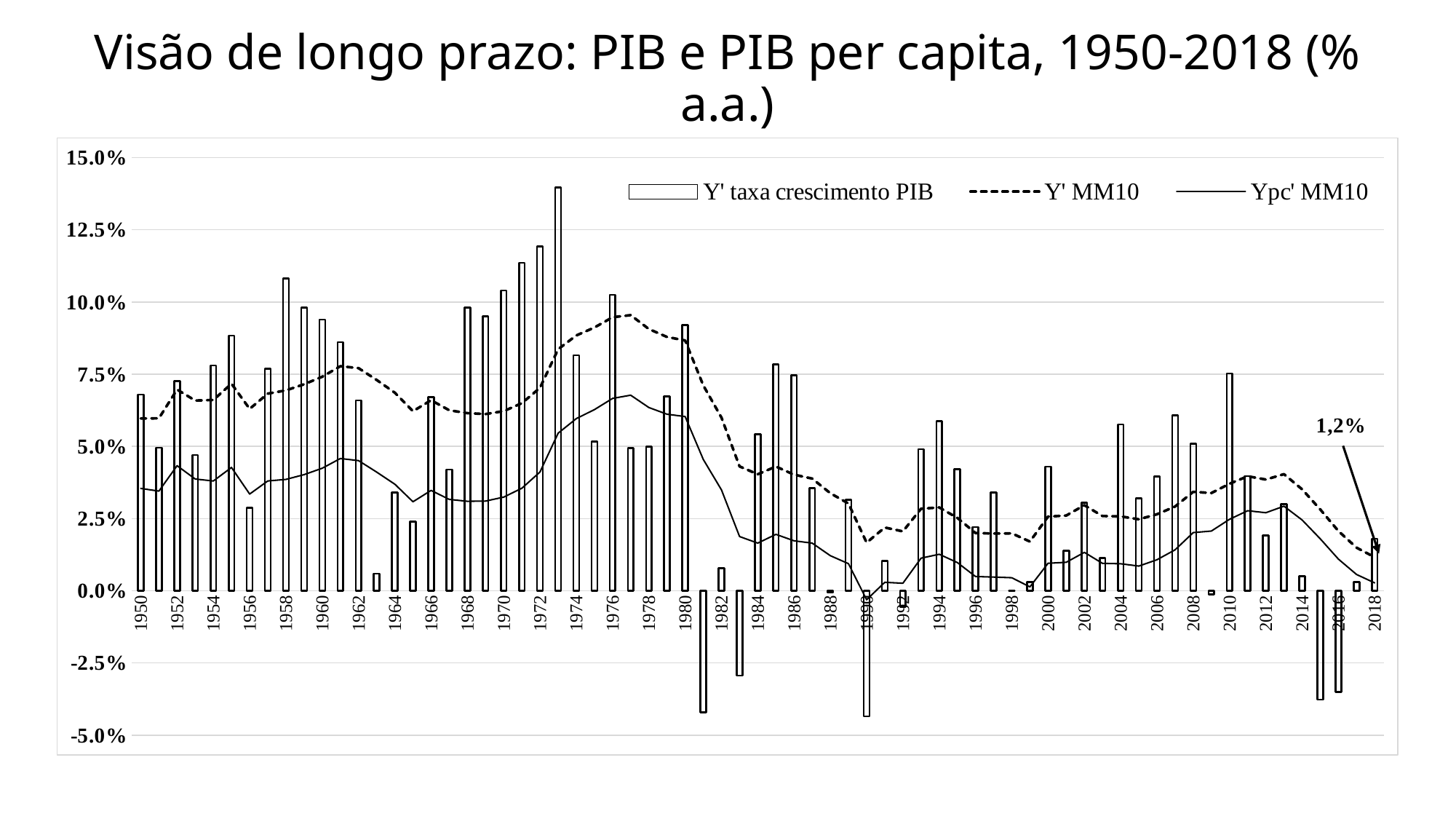
Which series in the legend is drawn as a dashed line? Y' MM10 Is the Y' taxa crescimento PIB value for 1981 greater or less than -2.5%? less How many series does the legend list? 3 Which year has the highest Y' taxa crescimento PIB bar? 1973 What is the title of the chart? Visão de longo prazo: PIB e PIB per capita, 1950-2018 (% a.a.) Is the Y' taxa crescimento PIB value for 1973 greater or less than 12.5%? greater What kind of chart is shown on the slide? A combined bar and line chart Is the Y' taxa crescimento PIB value for 2015 greater or less than -2.5%? less Does the Y' MM10 line rise or fall between 1976 and 1990? It falls Which year has the larger Y' taxa crescimento PIB bar, 1973 or 1976? 1973